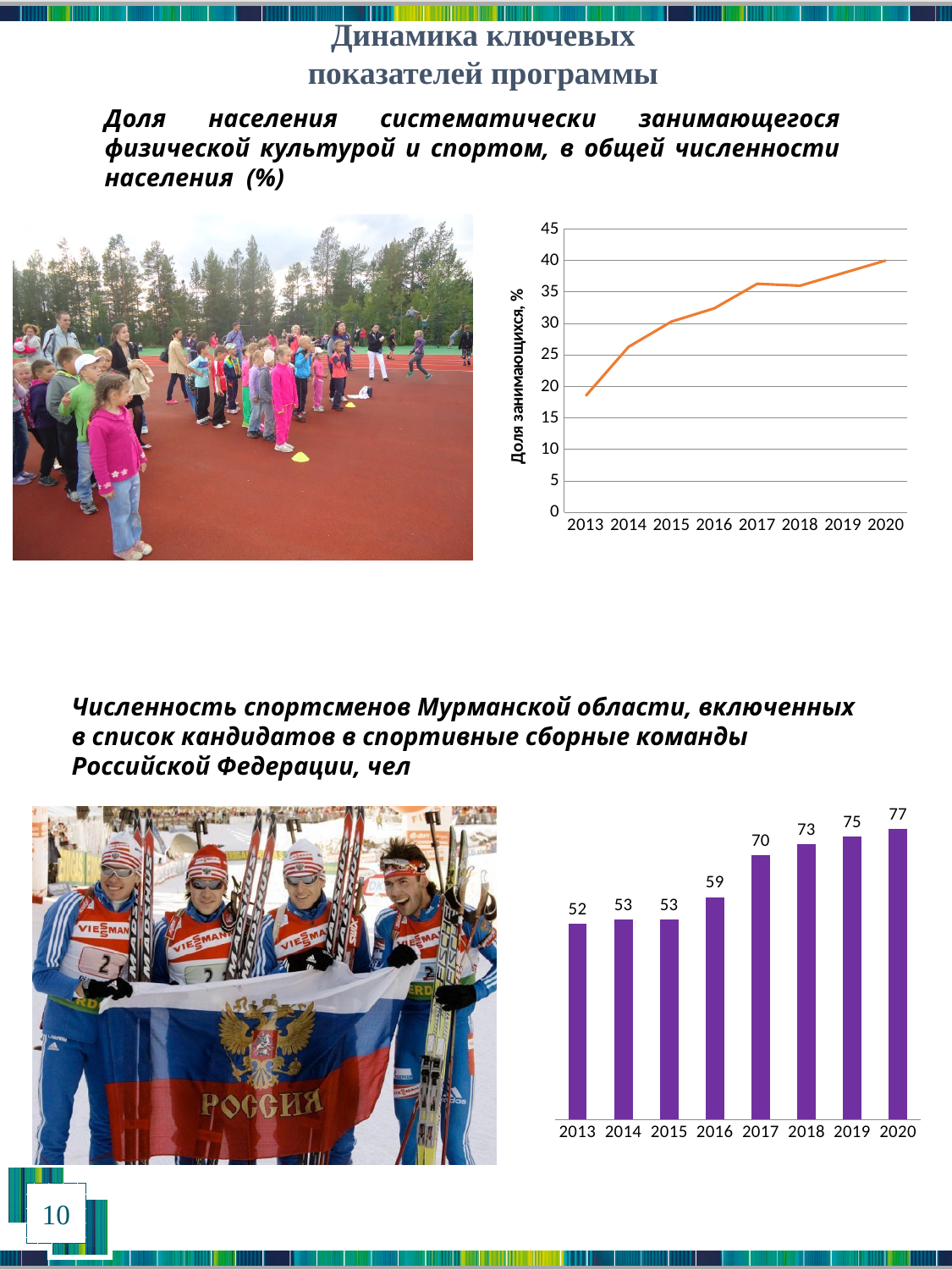
In the bottom bar chart, how many years are shown on the x axis? 8 In the bottom bar chart, what is the difference between the values for 2020 and 2013? 25 In the bottom bar chart, which year has the highest value? 2020 In the top line chart (share of population systematically engaged in physical culture and sport), do the values generally rise or fall from 2013 to 2020? rise In the bottom bar chart, which year has the lowest value? 2013 In the bottom bar chart (number of Murmansk region athletes on national team candidate lists), what is the value for 2020? 77 In the top line chart, is the value for 2017 greater or less than 35? greater In the bottom bar chart, what is the difference between the values for 2017 and 2016? 11 What kind of chart is the top chart on the slide? line chart In the top line chart, is the value for 2013 greater or less than 20? less In the bottom bar chart, what is the value for 2016? 59 What kind of chart is the bottom chart on the slide? bar chart